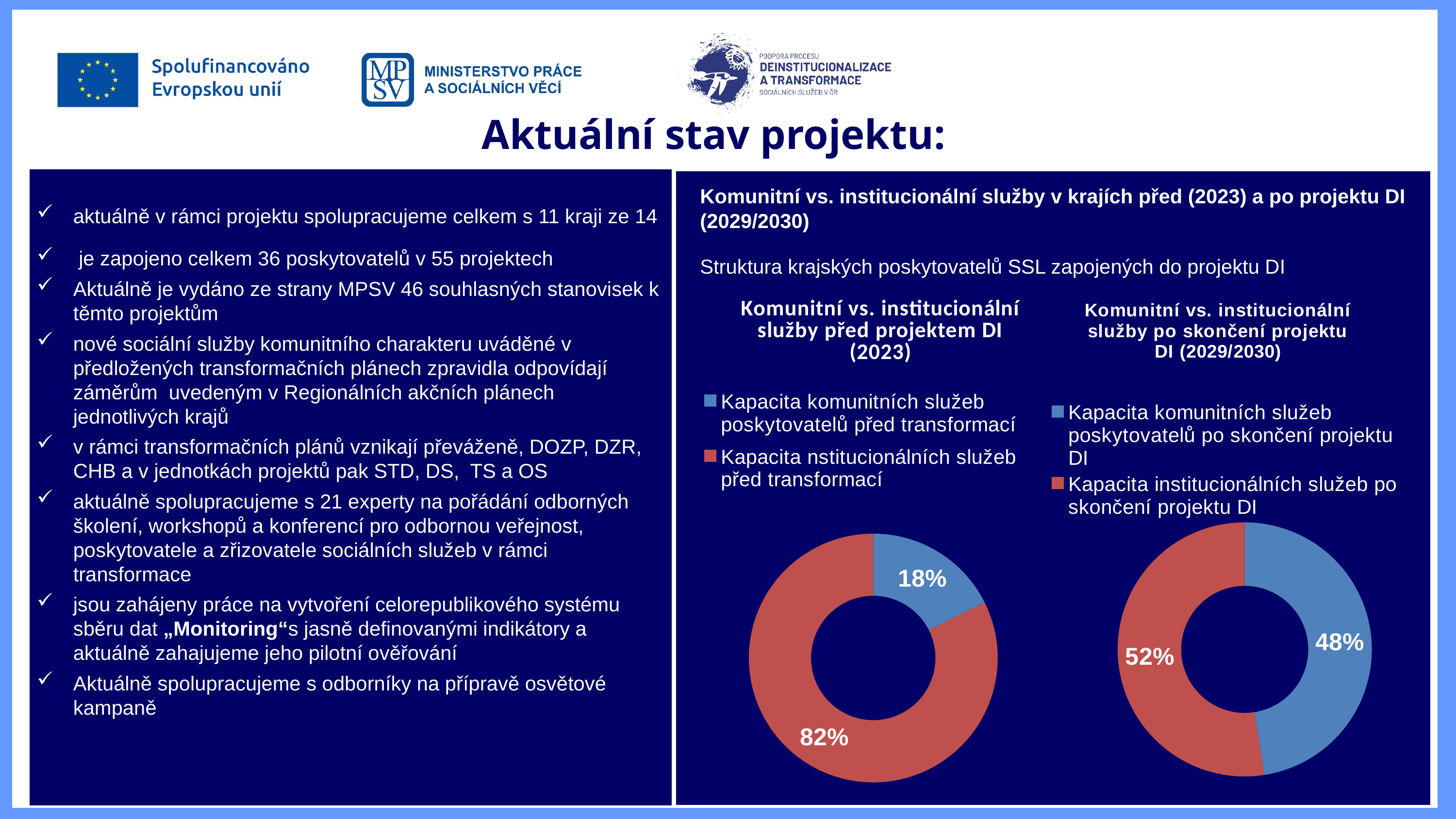
In the left chart (Komunitní vs. institucionální služby před projektem DI (2023)), what share is shown for Kapacita komunitních služeb poskytovatelů před transformací? 18% How many entries does the legend of the right chart (po skončení projektu DI, 2029/2030) list? 2 How many slices does the left chart (před projektem DI, 2023) have? 2 In the right chart (po skončení projektu DI, 2029/2030), what is the difference between the institutional and community shares? 4 percentage points In the left chart (před projektem DI, 2023), what colour is the slice for Kapacita komunitních služeb poskytovatelů před transformací? Blue In the right chart (po skončení projektu DI, 2029/2030), what share is shown for Kapacita institucionálních služeb po skončení projektu DI? 52% In the left chart (před projektem DI, 2023), what is the difference between the institutional and community shares? 64 percentage points In the right chart (po skončení projektu DI, 2029/2030), which slice is the smallest? Kapacita komunitních služeb poskytovatelů po skončení projektu DI What kind of chart is the left chart (před projektem DI, 2023)? Doughnut (pie) chart In the right chart (po skončení projektu DI, 2029/2030), what share is shown for Kapacita komunitních služeb poskytovatelů po skončení projektu DI? 48% In the left chart (před projektem DI, 2023), what share is shown for Kapacita nstitucionálních služeb před transformací? 82% In the left chart (před projektem DI, 2023), which slice is the largest? Kapacita nstitucionálních služeb před transformací